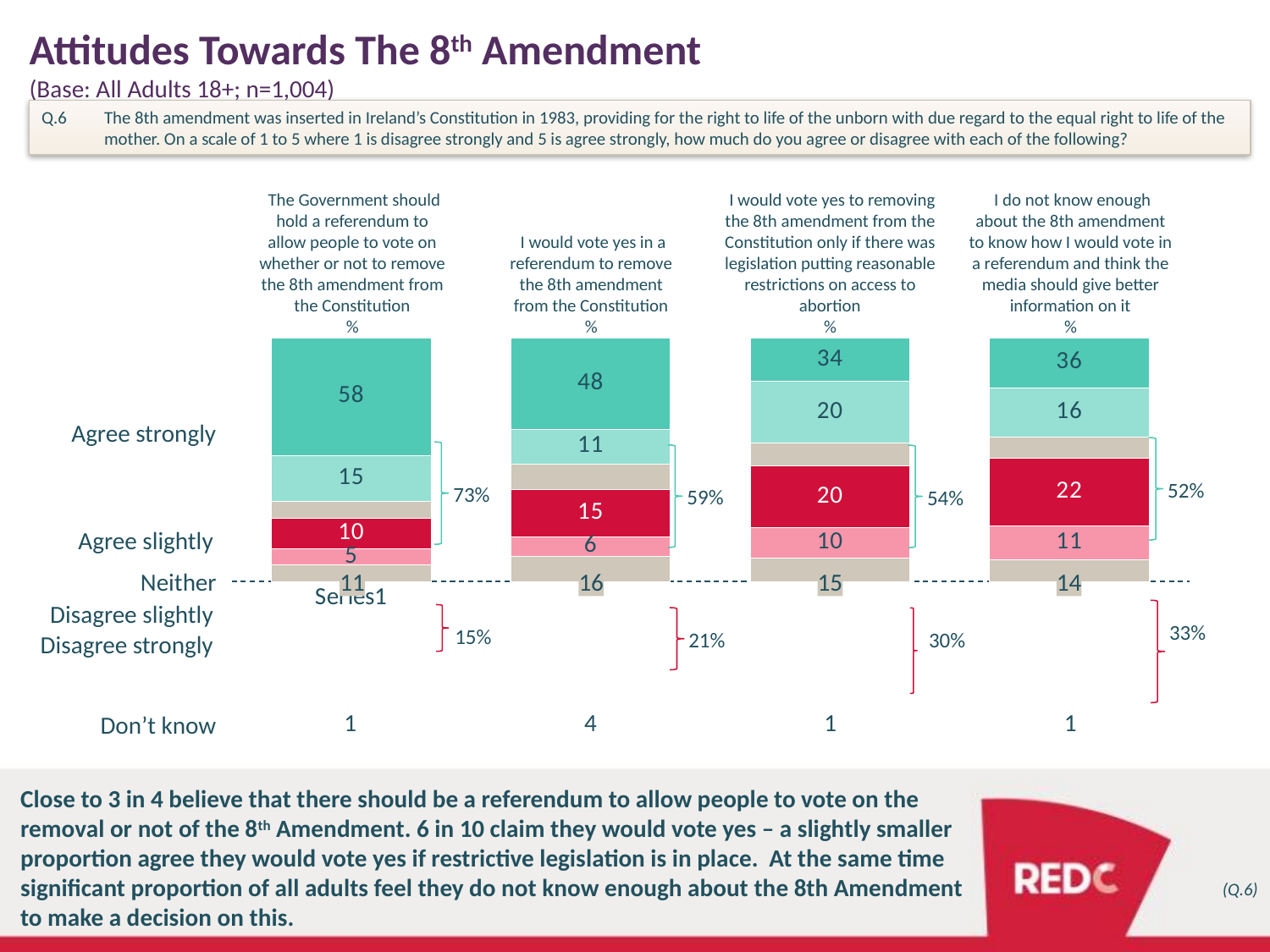
Which is larger: the combined disagree percentage for the 'vote yes only if there was legislation' statement or for the 'do not know enough' statement? do not know enough (33%) How many statements (stacked bars) are shown in the chart? 4 Which statement has the lowest combined disagree percentage? The Government should hold a referendum to allow people to vote on whether or not to remove the 8th amendment from the Constitution What is the combined disagree percentage (bracket) for the statement 'I would vote yes in a referendum to remove the 8th amendment from the Constitution'? 21% What is the difference between the combined agree percentages for the referendum statement (73%) and the 'vote yes' statement (59%)? 14% What is the 'Agree strongly' value for the statement 'I would vote yes in a referendum to remove the 8th amendment from the Constitution'? 48 What kind of chart is shown on the slide? Stacked bar chart Which statement has the highest combined agree percentage? The Government should hold a referendum to allow people to vote on whether or not to remove the 8th amendment from the Constitution What is the 'Don't know' value for the statement 'I would vote yes in a referendum to remove the 8th amendment from the Constitution'? 4 What is the combined agree percentage (bracket) for the statement 'I do not know enough about the 8th amendment to know how I would vote in a referendum and think the media should give better information on it'? 52% What is the base (sample size) stated for the chart? All Adults 18+; n=1,004 What is the combined agree percentage (bracket) for the statement 'The Government should hold a referendum to allow people to vote on whether or not to remove the 8th amendment from the Constitution'? 73%